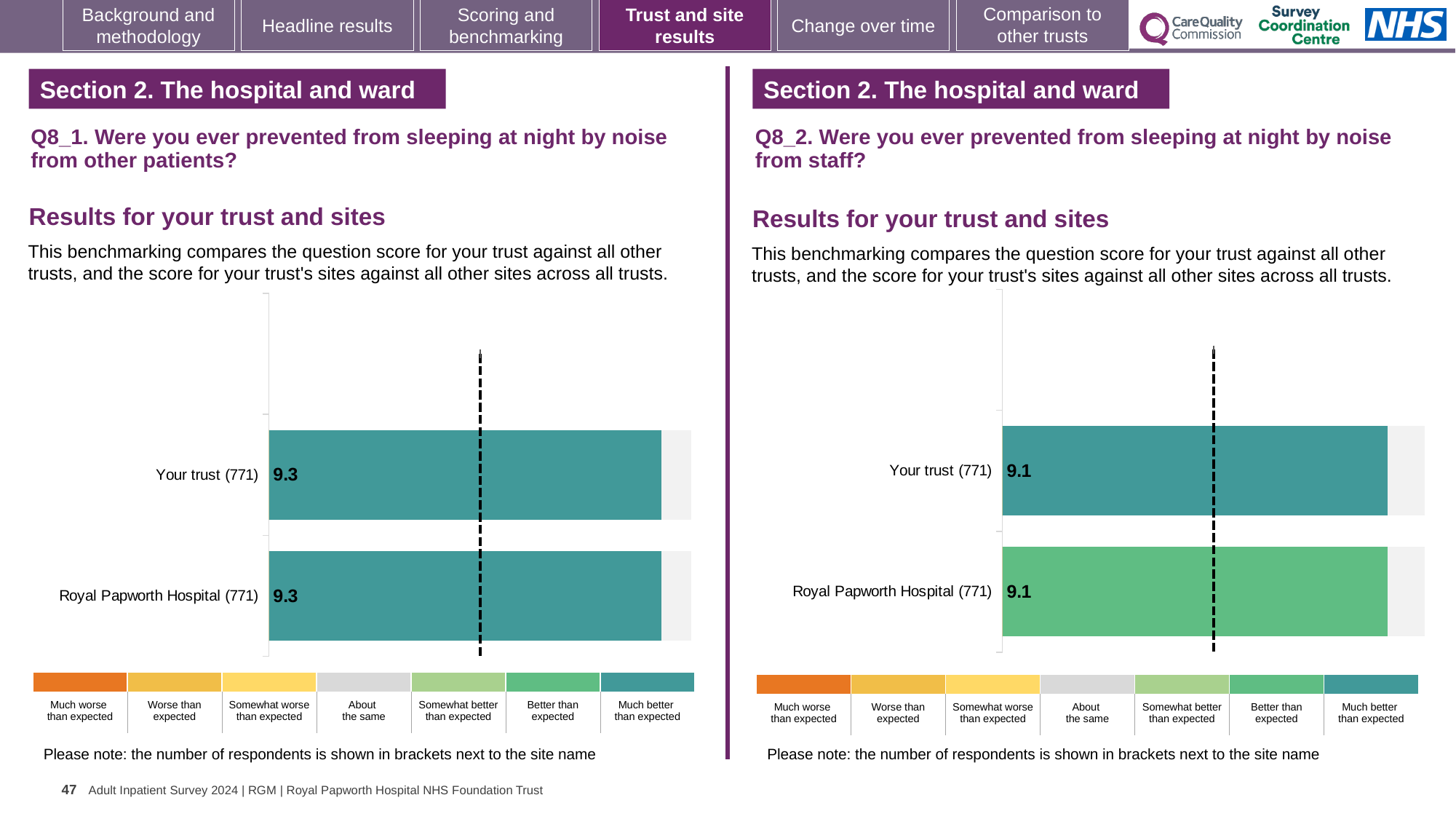
In the Q8_1 chart (left), what is the score for Royal Papworth Hospital (771)? 9.3 In the Q8_1 chart (left), what is the score for Your trust (771)? 9.3 In the Q8_2 chart (right), what is the difference between the score for Your trust and the score for Royal Papworth Hospital? 0 In the Q8_1 chart (left), what is the difference between the score for Your trust and the score for Royal Papworth Hospital? 0 Is the score for Your trust in the Q8_1 chart (left) higher or lower than the score for Your trust in the Q8_2 chart (right)? Higher In the Q8_2 chart (right), what is the score for Your trust (771)? 9.1 How many respondents are shown in brackets next to Your trust in the Q8_1 chart (left)? 771 How many bars are plotted in the Q8_2 chart (right)? 2 In the Q8_2 chart (right), which benchmark category does the colour of the Royal Papworth Hospital bar correspond to in the legend? Better than expected What kind of chart is used in the Q8_1 chart (left)? Bar chart How many bars are plotted in the Q8_1 chart (left)? 2 In the Q8_2 chart (right), what is the score for Royal Papworth Hospital (771)? 9.1